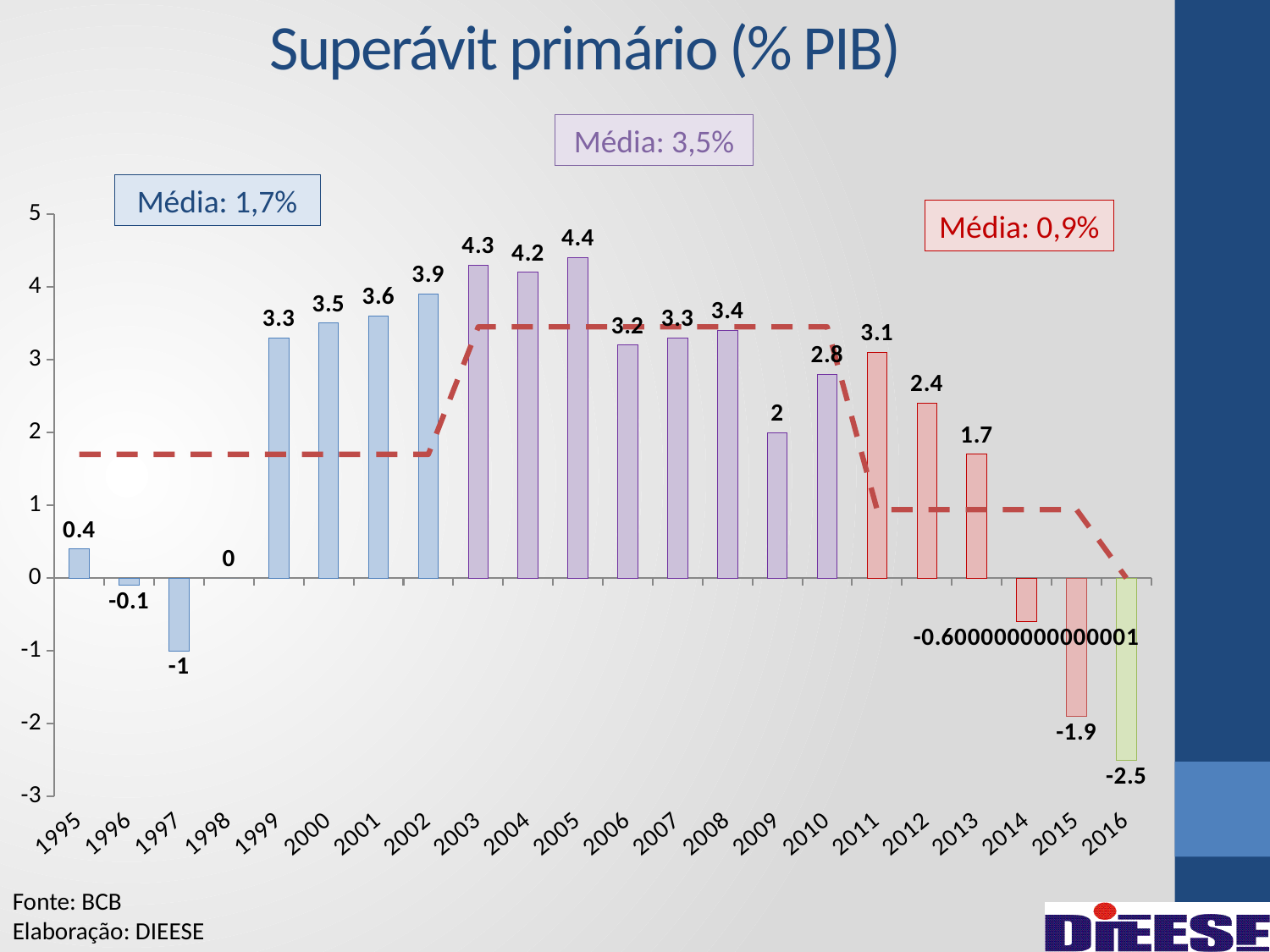
Do the values rise or fall from 2011 to 2016? fall Is the value for 2012 greater or less than 2? greater What is the value for 1997? -1 Which year has the lowest value? 2016 What is the value for 2013? 1.7 How many years are shown on the x axis? 22 Which year has the highest value? 2005 What kind of chart is this? combination bar and line chart Which is larger, the value for 2002 or the value for 2010? 2002 What is the title of the chart? Superávit primário (% PIB) What is the value for 2005? 4.4 What is the difference between the values for 2003 and 2009? 2.3